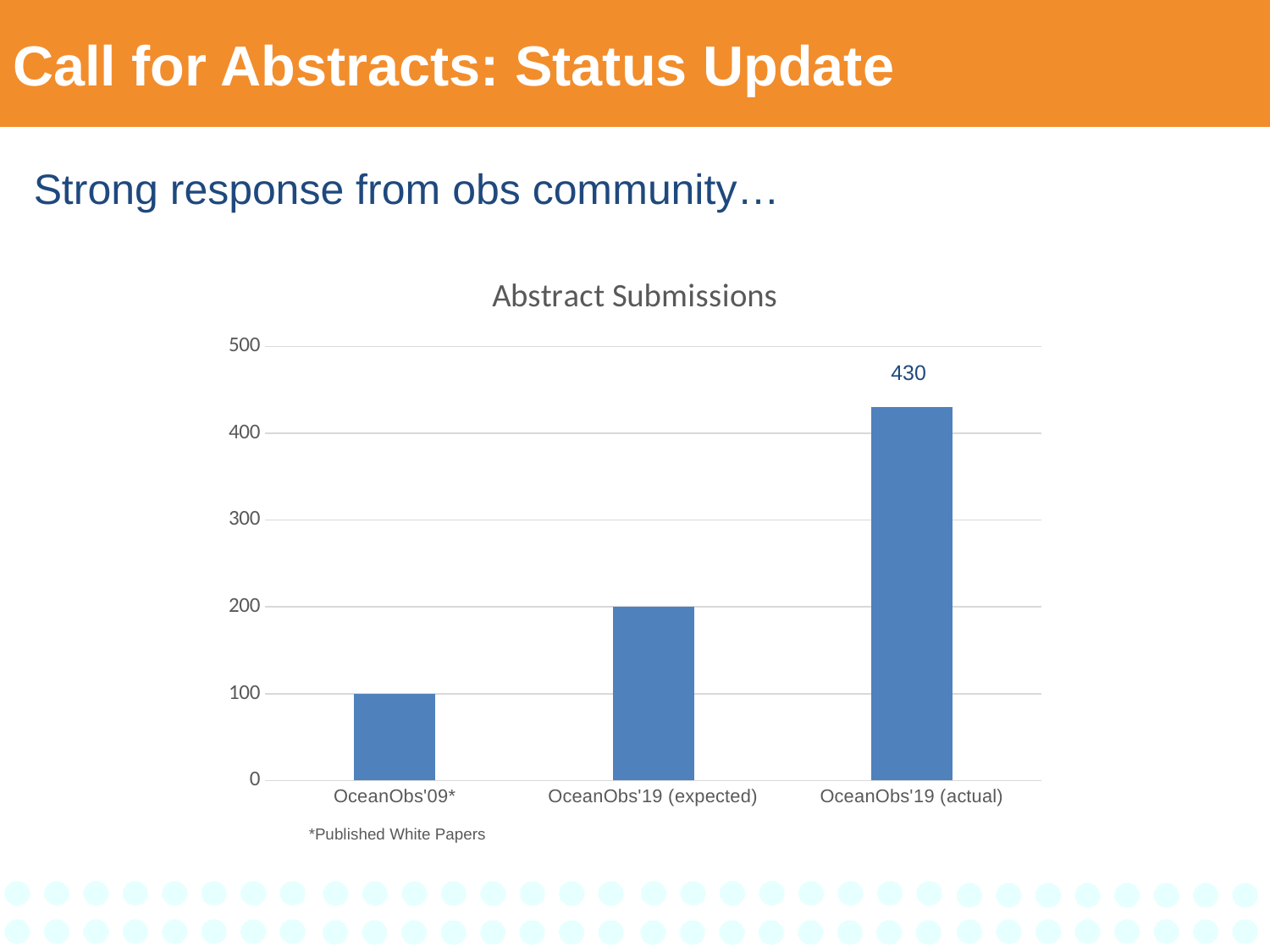
Which category has the highest value in the Abstract Submissions chart? OceanObs'19 (actual) What is the value for OceanObs'19 (actual) in the Abstract Submissions chart? 430 Is the value for OceanObs'19 (actual) greater or less than 400? greater What is the title of the chart on the slide? Abstract Submissions What kind of chart is shown on the slide? bar chart How many categories are shown in the Abstract Submissions chart? 3 What is the value for OceanObs'09* in the Abstract Submissions chart? 100 What is the difference between OceanObs'19 (actual) and OceanObs'19 (expected)? 230 Which category has the lowest value in the Abstract Submissions chart? OceanObs'09* Which is larger, OceanObs'19 (expected) or OceanObs'09*? OceanObs'19 (expected) What is the value for OceanObs'19 (expected) in the Abstract Submissions chart? 200 What is the difference between OceanObs'19 (expected) and OceanObs'09*? 100